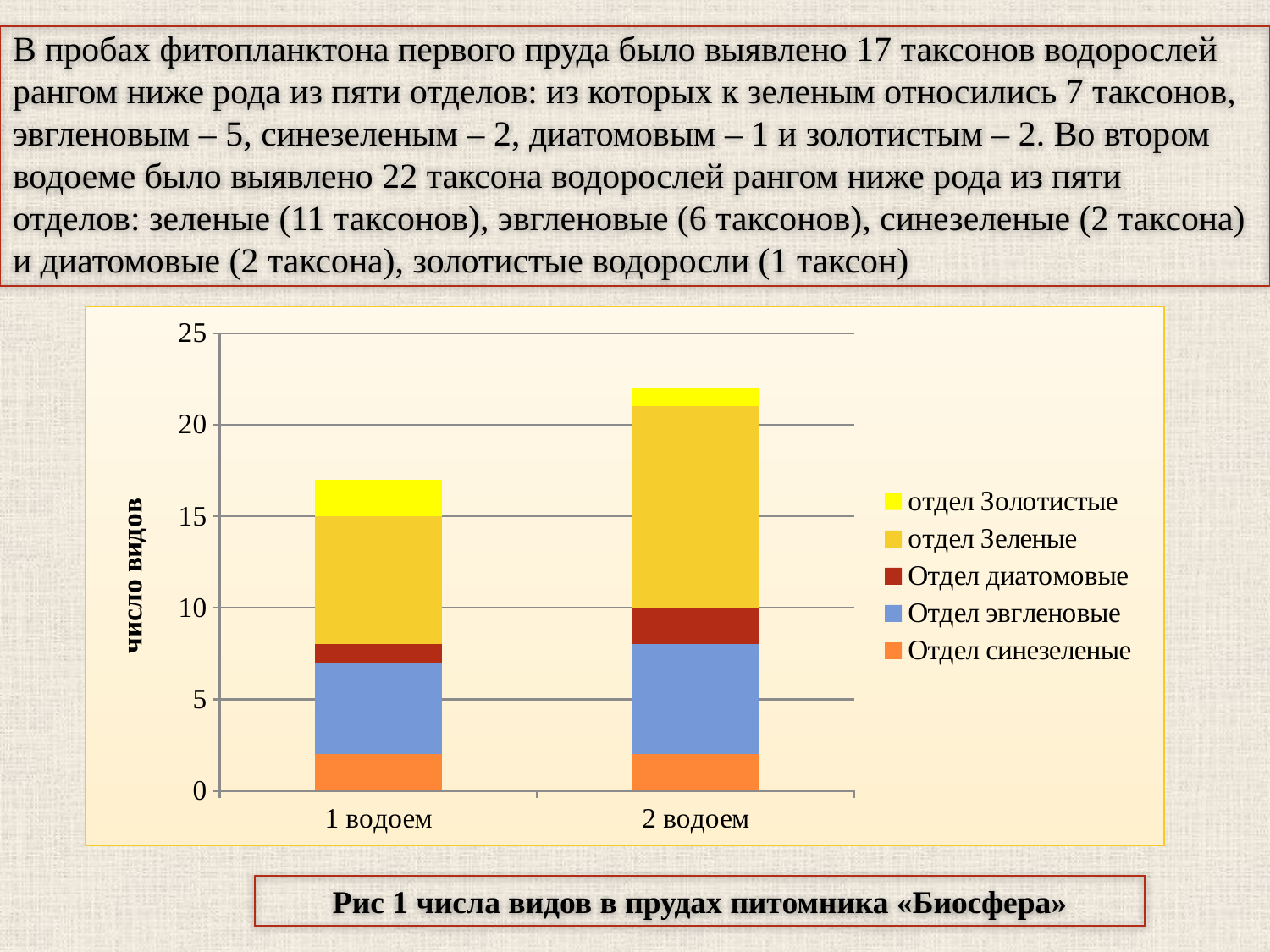
Which водоем has the shorter stacked bar? 1 водоем How many categories (водоемы) are shown on the x axis of the chart? 2 According to the slide text, what is the difference between the total number of taxa in 2 водоем and in 1 водоем? 5 Is the total height of the stacked bar for 1 водоем greater or less than 15? greater Is the отдел Зеленые segment larger for 1 водоем or for 2 водоем? 2 водоем How many series does the chart legend list? 5 Which legend entry is shown in bright yellow? отдел Золотистые Which водоем has the taller stacked bar? 2 водоем What is the label of the y axis of the chart? число видов What kind of chart is shown on the slide? stacked bar chart According to the slide text, what is the total number of taxa in the stacked bar for 2 водоем? 22 Is the total height of the stacked bar for 2 водоем greater or less than 20? greater